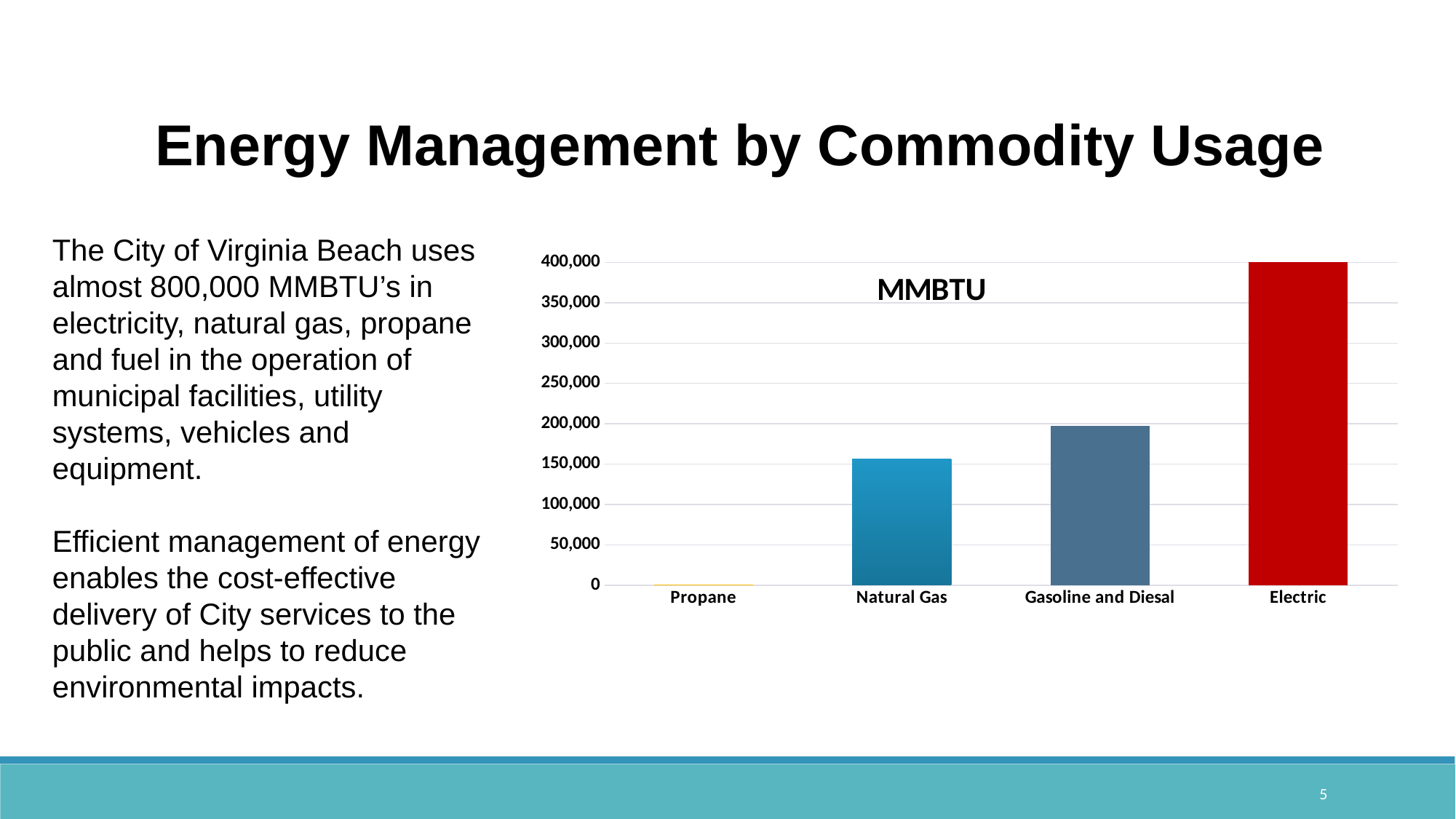
Is the value for Natural Gas greater or less than 150,000? greater What is the title of the chart? MMBTU Which is larger, the value for Electric or the value for Gasoline and Diesal? Electric Is the value for Electric greater or less than 350,000? greater Is the value for Propane greater or less than 50,000? less How many categories are shown on the x axis of the chart? 4 What kind of chart is shown on the slide? bar chart Which category has the lowest value in the chart? Propane Which category has the highest value in the chart? Electric Which is larger, the value for Natural Gas or the value for Gasoline and Diesal? Gasoline and Diesal Do the values rise or fall moving from left to right along the x axis? rise